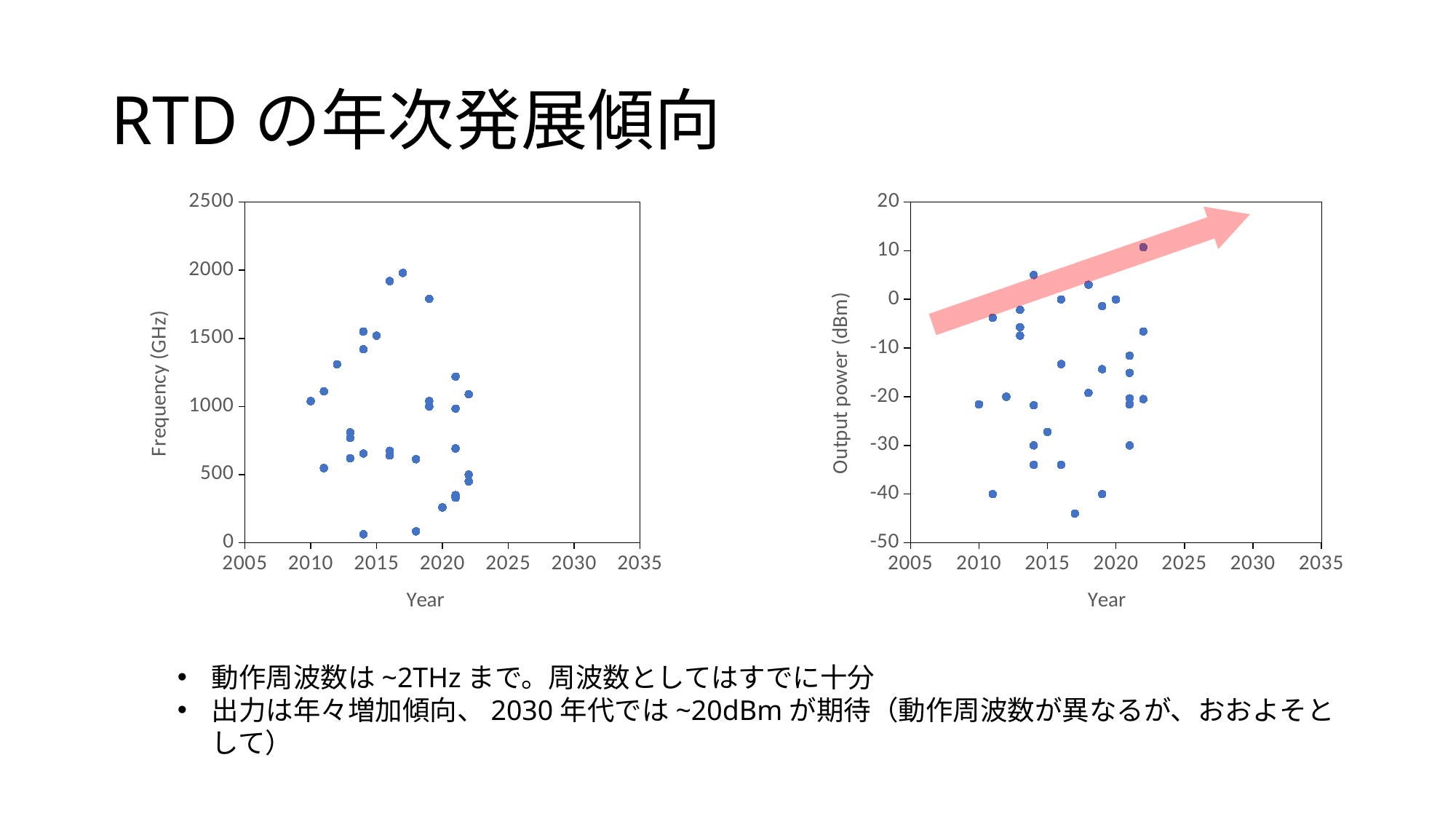
In the right chart, in which year does the highest output power point appear? 2022 In the left chart, what is the y-axis title? Frequency (GHz) In the right chart, is the highest plotted output power greater or less than 0 dBm? greater What kind of chart is the right chart (Output power vs Year)? scatter chart What kind of chart is the left chart (Frequency vs Year)? scatter chart In the right chart, is the lowest plotted output power greater or less than -40 dBm? less In the left chart, is the highest plotted frequency greater or less than 1500 GHz? greater In the right chart, in which year does the lowest output power point appear? 2017 In the right chart, does the overall output power trend indicated by the arrow rise or fall over the years? rise In the left chart, what is the maximum value shown on the y-axis? 2500 In the right chart, what is the y-axis title? Output power (dBm)